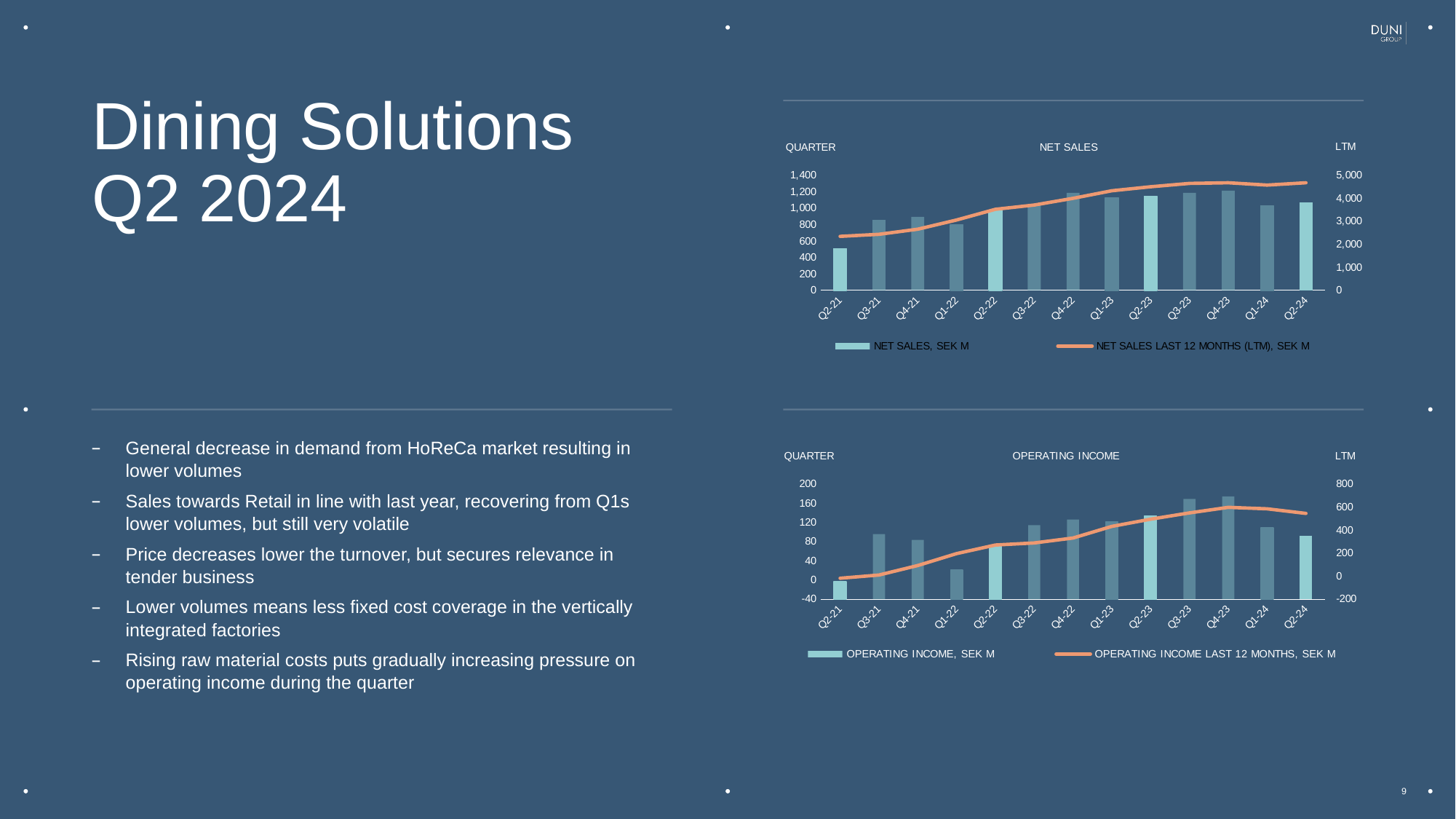
In the NET SALES chart, is the quarterly net sales value for Q4-22 greater or less than 1,000? greater In the NET SALES chart, is the quarterly net sales value for Q2-21 greater or less than 600? less In the NET SALES chart, does the NET SALES LAST 12 MONTHS (LTM) line generally rise or fall from Q2-21 to Q2-24? rise In the NET SALES chart, which quarter has the lowest quarterly net sales bar? Q2-21 How many quarters are shown on the x axis of the NET SALES chart? 13 In the OPERATING INCOME chart, which quarter has the lowest quarterly operating income bar? Q2-21 In the OPERATING INCOME chart, is the quarterly operating income for Q1-22 greater or less than 40? less What kind of chart is the NET SALES chart? bar chart with a line How many series does the legend of the OPERATING INCOME chart list? 2 In the NET SALES chart, which quarter has the larger net sales bar, Q2-21 or Q3-21? Q3-21 In the OPERATING INCOME chart, which quarter has the larger operating income bar, Q1-22 or Q3-23? Q3-23